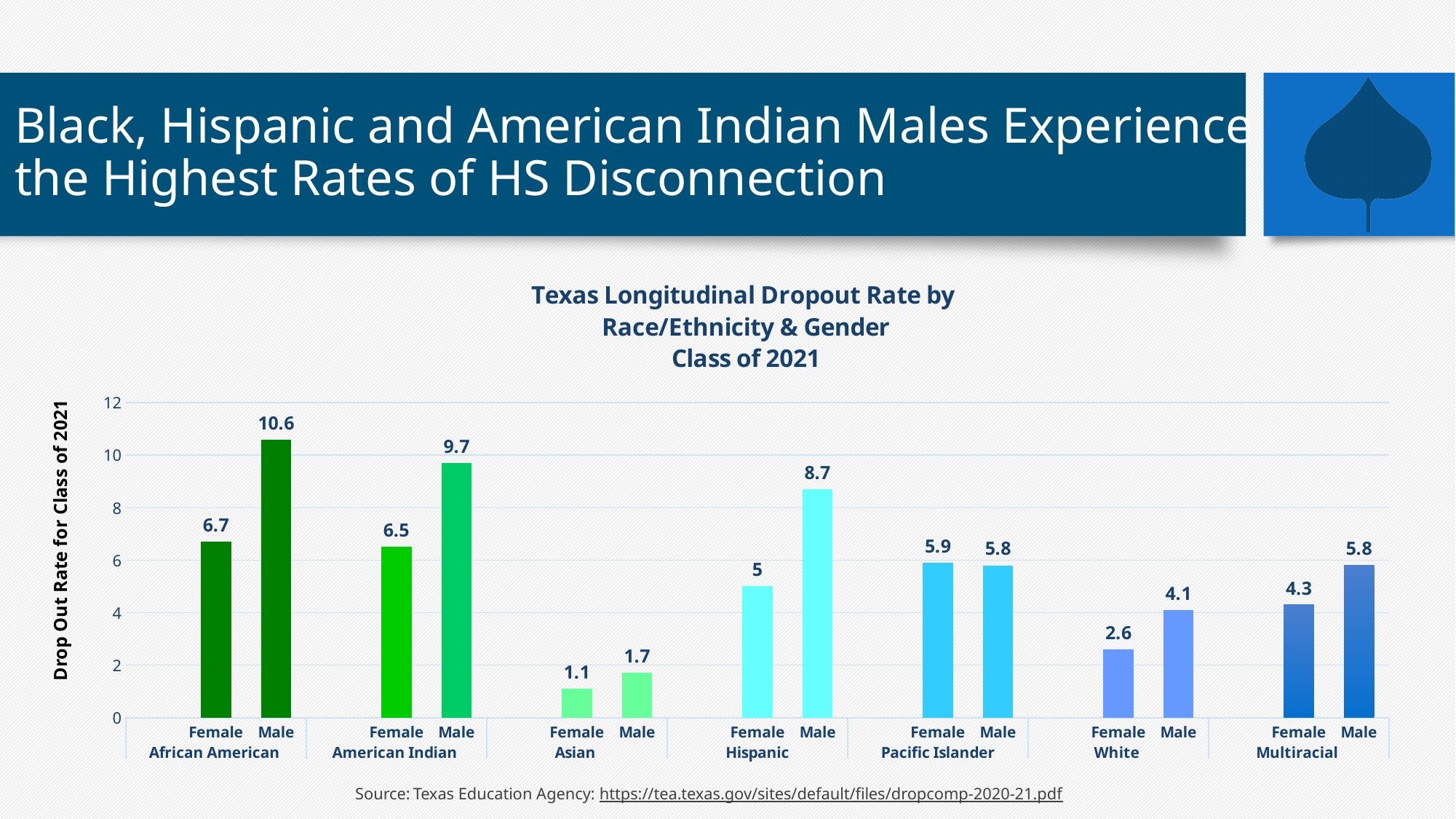
What is the dropout rate for White females? 2.6 What is the dropout rate for African American males? 10.6 What is the title of the chart? Texas Longitudinal Dropout Rate by Race/Ethnicity & Gender Class of 2021 Which group has the highest dropout rate? African American Male Which group has the lowest dropout rate? Asian Female How many bars are plotted in the chart? 14 What kind of chart is shown on the slide? Bar chart What is the difference between the dropout rates for American Indian males and American Indian females? 3.2 What is the dropout rate for Hispanic females? 5 What is the difference between the dropout rates for Hispanic males and Hispanic females? 3.7 Which is larger, the dropout rate for Multiracial males or White males? Multiracial males Which is larger, the dropout rate for Pacific Islander females or Pacific Islander males? Pacific Islander females